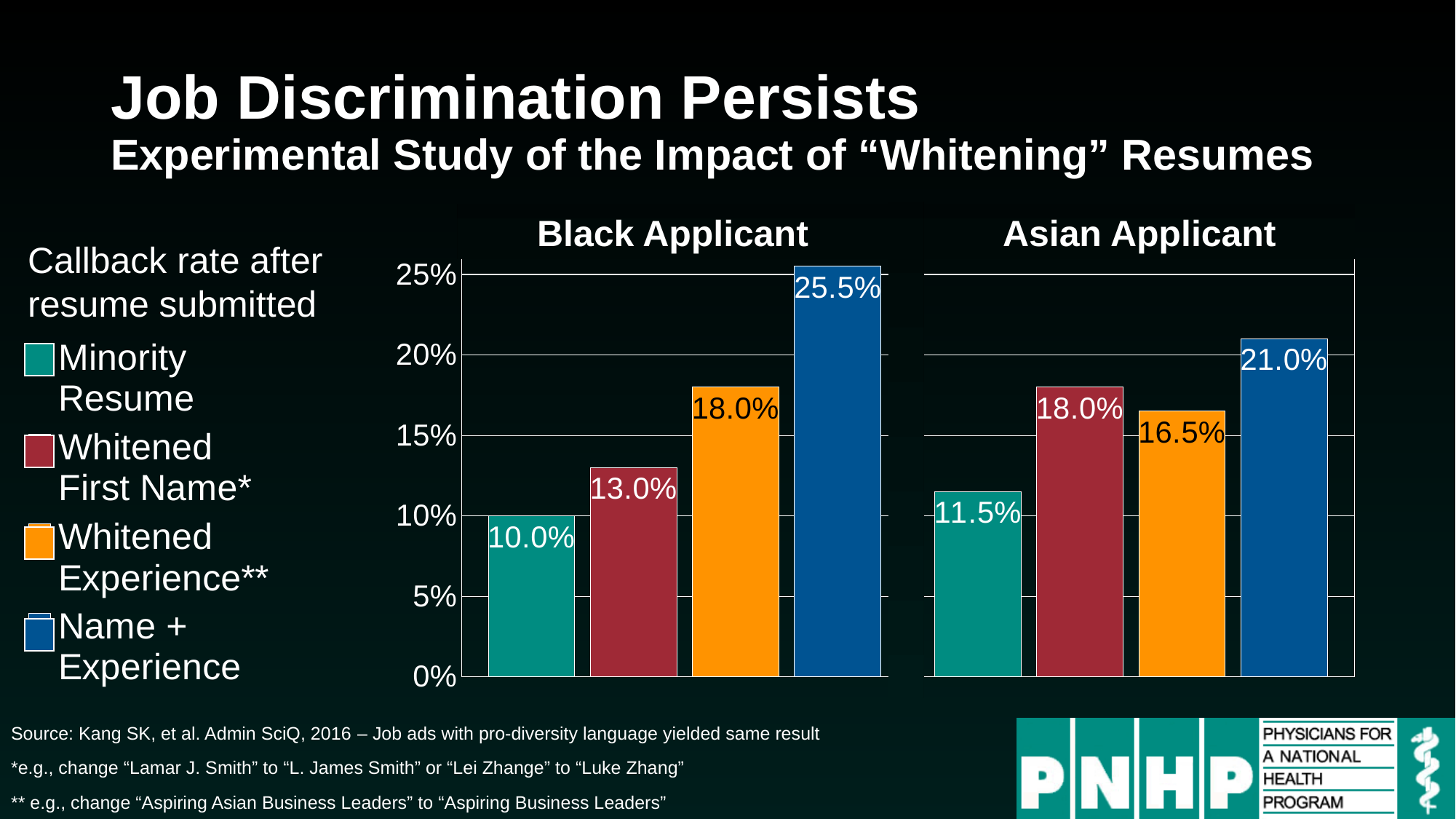
In the Asian Applicant chart, what is the callback rate for Whitened Experience? 16.5% What kind of chart is the Asian Applicant chart? Bar chart In the Asian Applicant chart, is the Name + Experience callback rate greater or less than 20%? greater In the Black Applicant chart, which is larger: the Whitened First Name callback rate or the Whitened Experience callback rate? Whitened Experience In the Black Applicant chart, which resume type has the highest callback rate? Name + Experience In the Black Applicant chart, what is the callback rate for the Minority Resume? 10.0% In the Black Applicant chart, what is the difference between the Name + Experience callback rate and the Minority Resume callback rate? 15.5% How many bars are shown in the Black Applicant chart? 4 In the Asian Applicant chart, what is the callback rate for Name + Experience? 21.0% How many resume types does the legend list? 4 In the Asian Applicant chart, which resume type has the lowest callback rate? Minority Resume In the Asian Applicant chart, what is the difference between the Whitened First Name and Whitened Experience callback rates? 1.5%